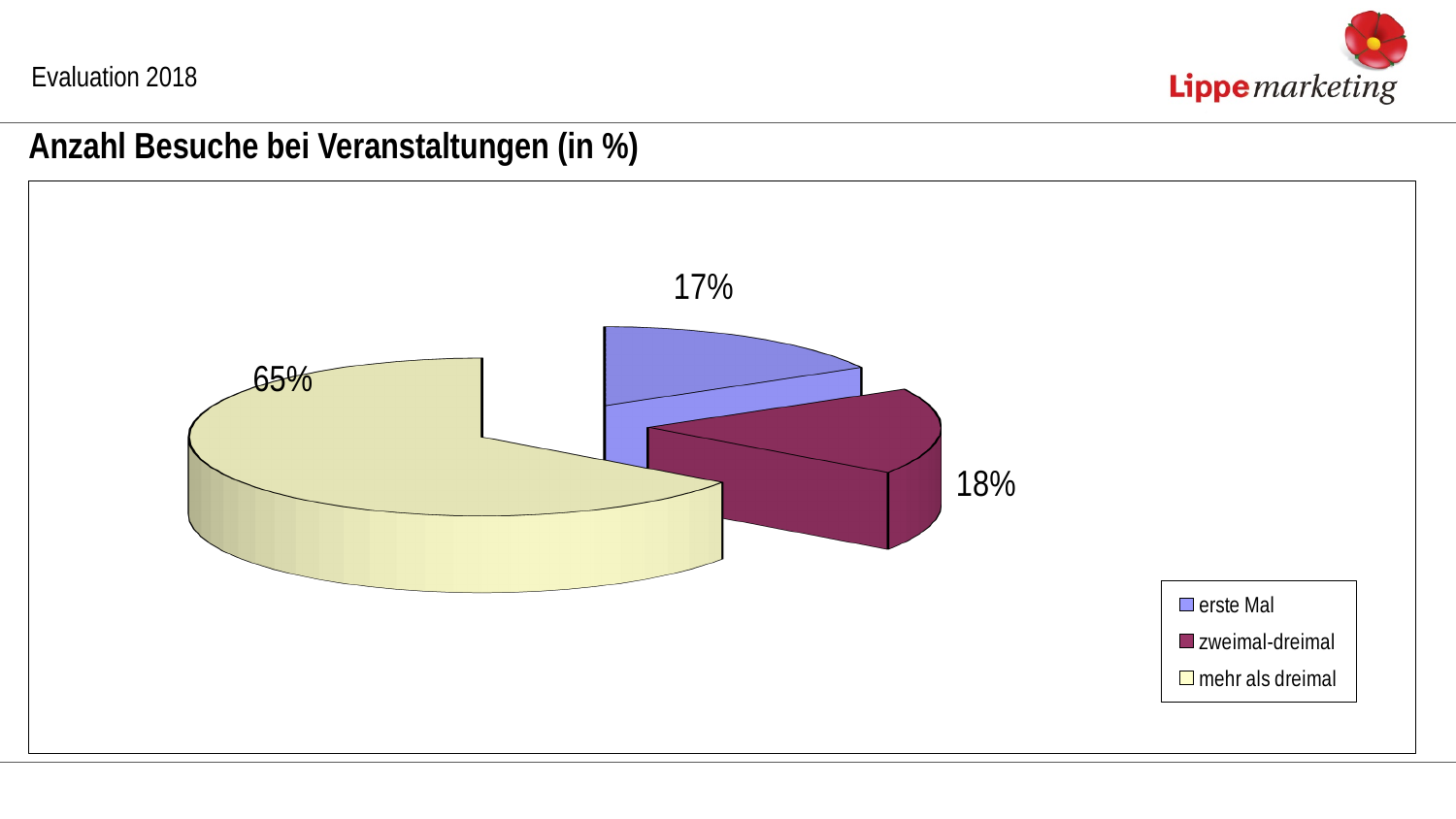
Which is larger, the share for 'mehr als dreimal' or the share for 'erste Mal'? mehr als dreimal What is the difference between the 'mehr als dreimal' share and the 'zweimal-dreimal' share? 47% How many categories are shown in the pie chart? 3 Which category has the smallest slice of the pie? erste Mal What is the value shown for 'zweimal-dreimal'? 18% What kind of chart is shown on the slide? pie chart Which colour represents 'zweimal-dreimal' in the legend? dark red What is the title of the chart? Anzahl Besuche bei Veranstaltungen (in %) Which category has the largest slice of the pie? mehr als dreimal What share of the pie does 'mehr als dreimal' represent? 65% What is the difference between the 'zweimal-dreimal' share and the 'erste Mal' share? 1% What is the value shown for 'erste Mal'? 17%